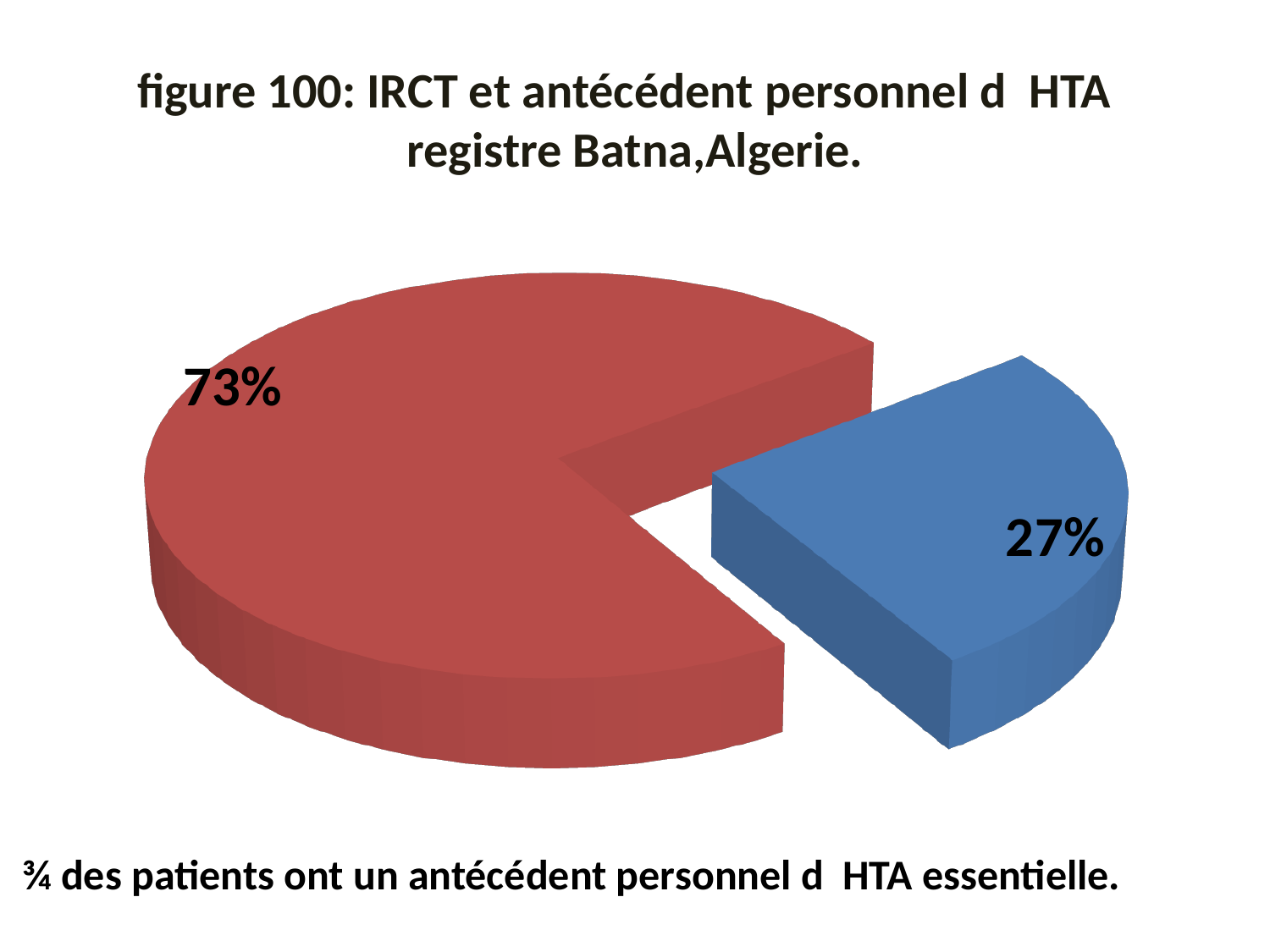
What is the title of the chart? figure 100: IRCT et antécédent personnel d HTA registre Batna,Algerie. Which slice is larger, the red slice or the blue slice? the red slice What colour is the slice that is pulled out from the rest of the pie? blue Is the share of the blue slice greater or less than 50%? less What kind of chart is shown on the slide? pie chart Which slice of the pie chart is the largest? the red slice (73%) How many slices does the pie chart have? 2 What percentage is shown on the red slice of the pie chart? 73% Which slice of the pie chart is the smallest? the blue slice (27%) What is the difference in percentage points between the red slice and the blue slice? 46 What percentage is shown on the blue slice of the pie chart? 27%